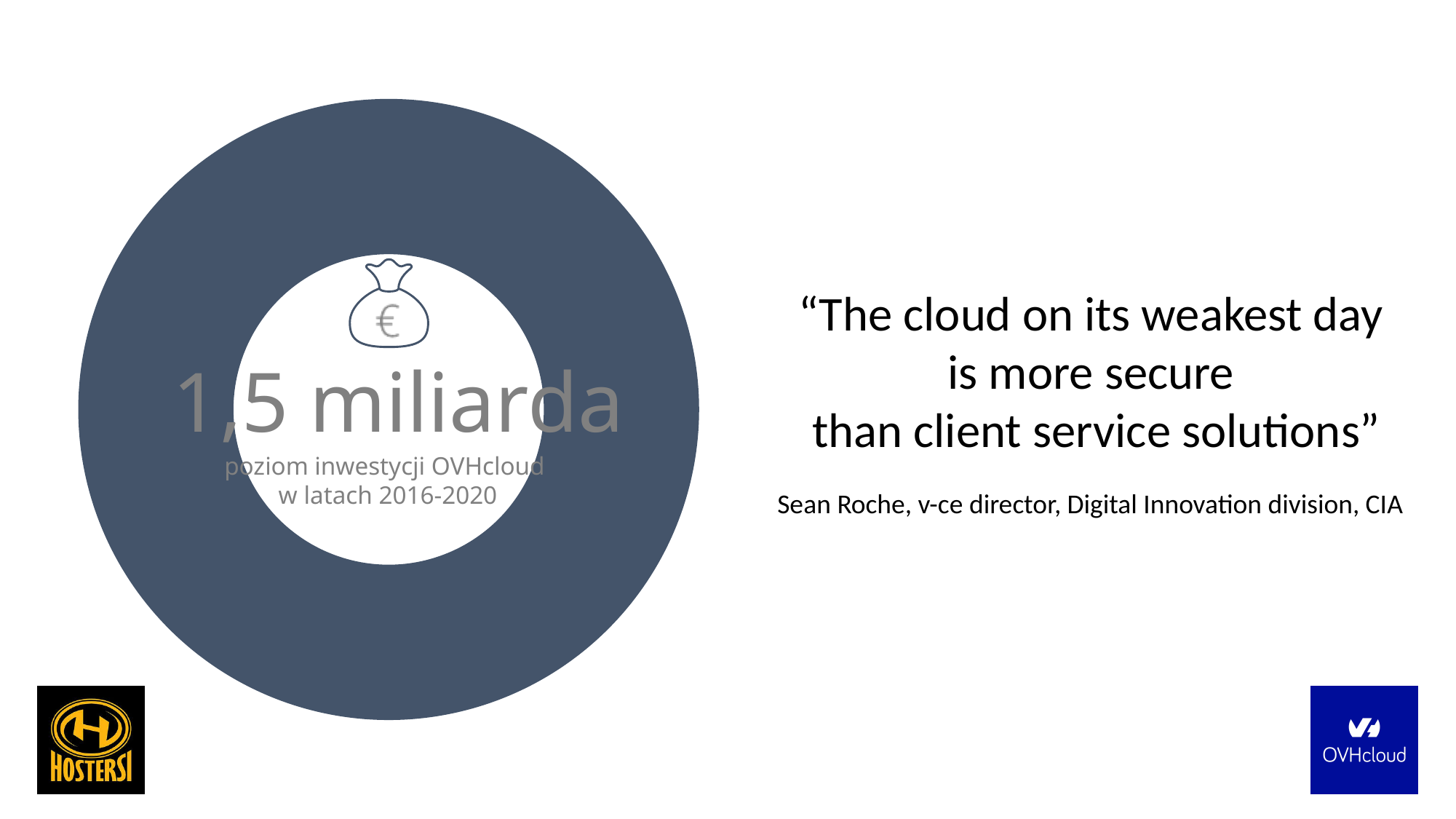
What kind of chart is the graphic on the left of the slide? doughnut chart Which years does the doughnut chart's caption say the investment figure covers? 2016-2020 What currency symbol appears in the money-bag icon inside the doughnut chart? € How many distinct slices does the doughnut ring on the left show? 1 What does the text under the central value of the doughnut chart say the figure represents? poziom inwestycji OVHcloud w latach 2016-2020 What value is printed in the centre of the doughnut chart? 1,5 miliarda